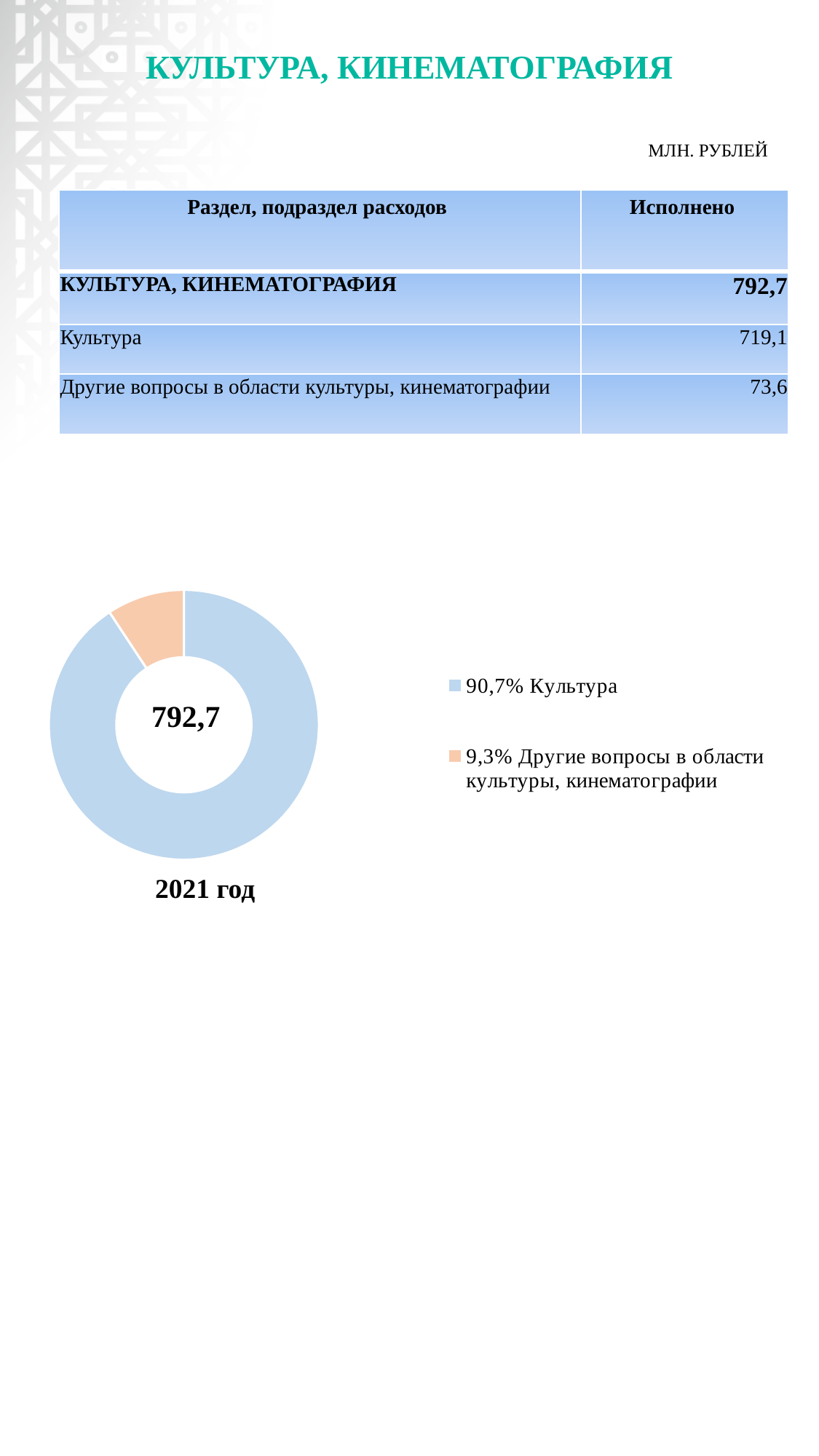
Which slice is larger: Культура or Другие вопросы в области культуры, кинематографии? Культура How many categories does the doughnut chart show? 2 What is the difference in percentage points between the Культура share and the Другие вопросы в области культуры, кинематографии share? 81,4 What year is shown as the title below the doughnut chart? 2021 год What share of the doughnut chart does Другие вопросы в области культуры, кинематографии account for? 9,3% What colour is the Культура slice in the doughnut chart? Light blue Which category has the smallest slice in the doughnut chart? Другие вопросы в области культуры, кинематографии What share of the doughnut chart does Культура account for? 90,7% What total value is printed in the centre of the doughnut chart? 792,7 What kind of chart is shown on the slide? Doughnut (pie) chart Which category has the largest slice in the doughnut chart? Культура